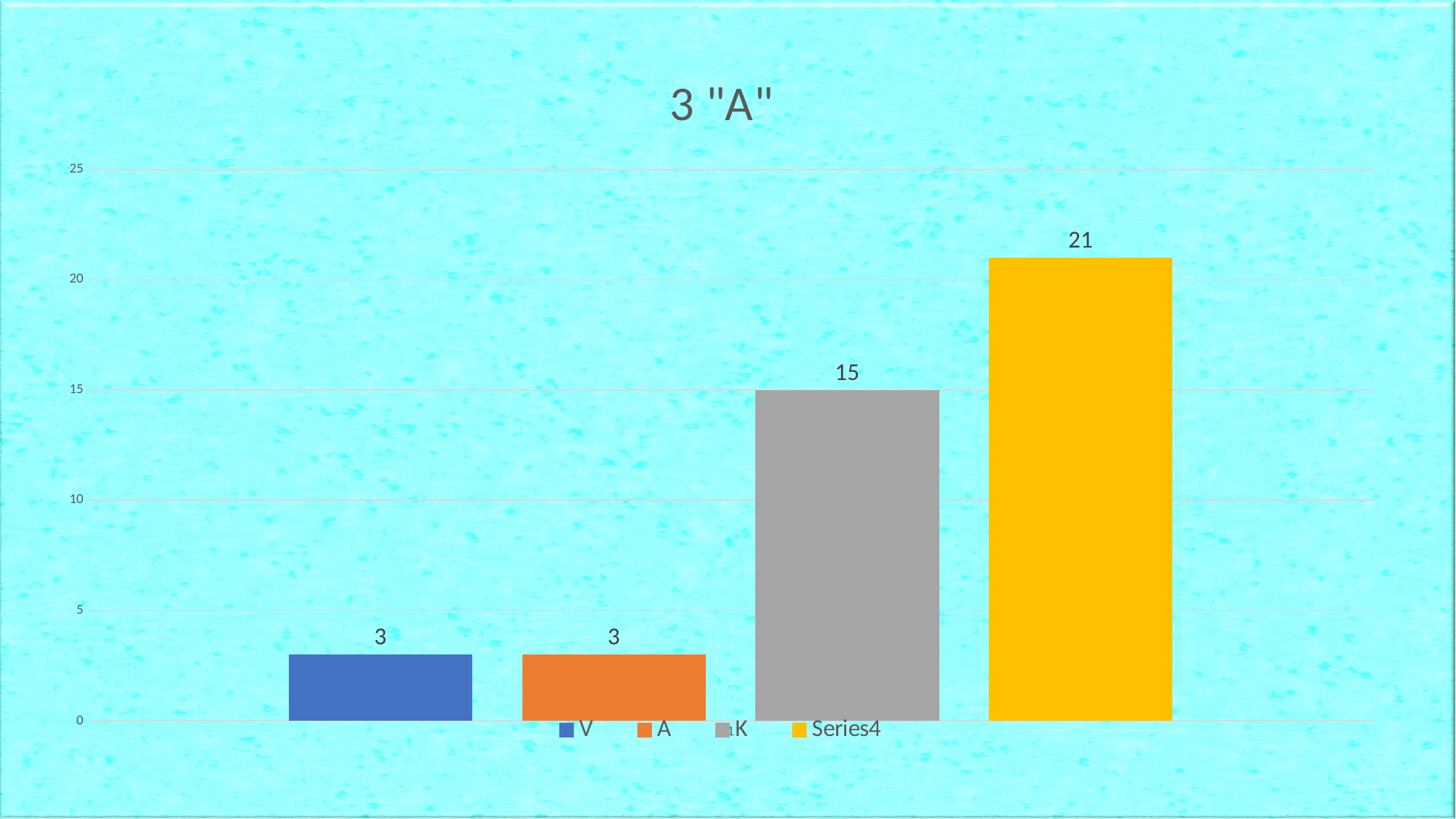
What is the value for V? 3 How many series does the legend list? 4 What kind of chart is shown on the slide? bar chart What is the difference between the values for Series4 and K? 6 What is the value for Series4? 21 Which is larger, the value for K or the value for A? K Is the value for Series4 greater or less than 20? greater What is the value for K? 15 What is the difference between the values for K and V? 12 What is the title of the chart? 3 "A" Which series has the highest value? Series4 What is the value for A? 3